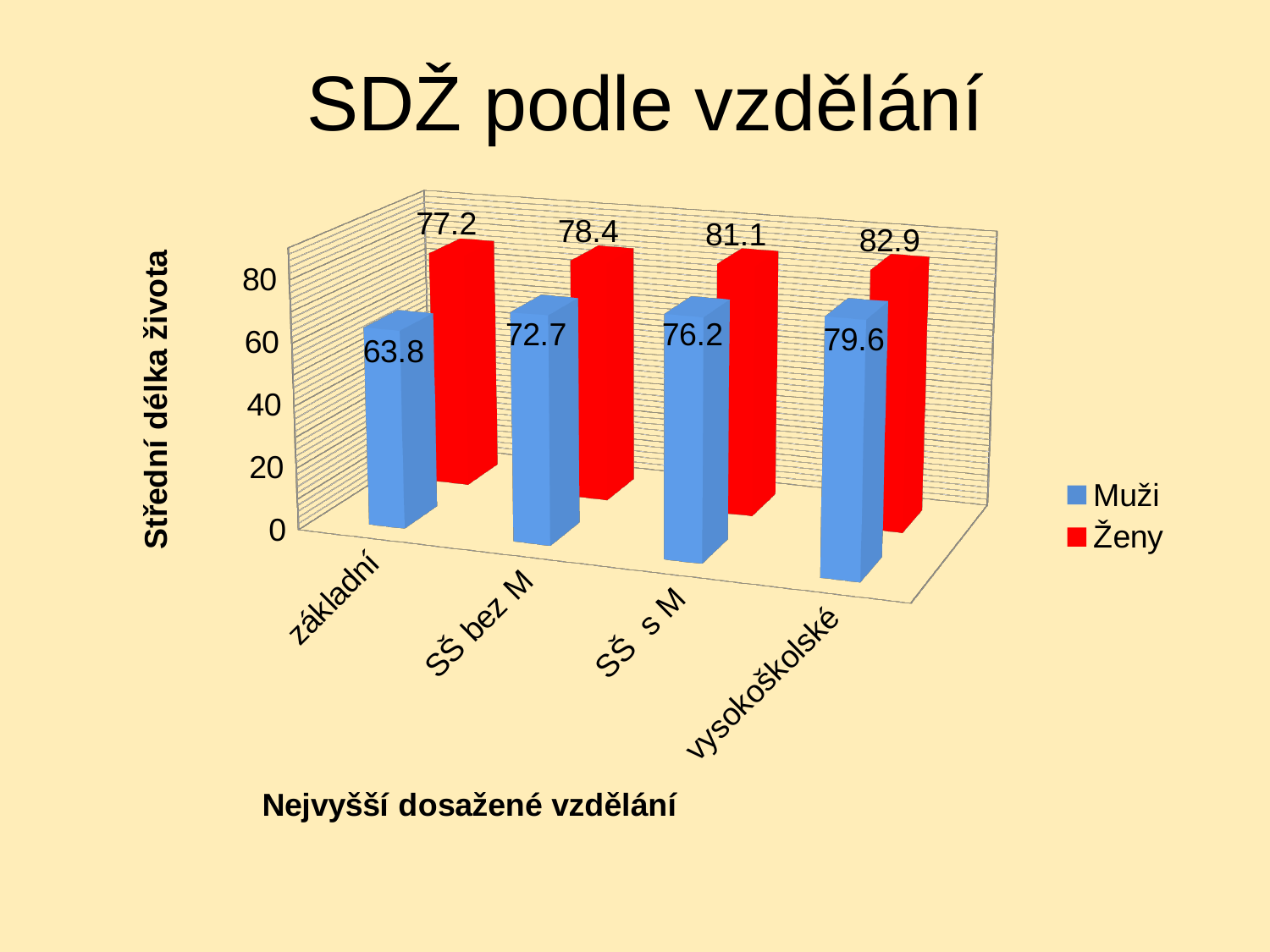
How many series does the legend list? 2 What is the difference between the Ženy and Muži values in the základní category? 13.4 What is the value for Ženy in the SŠ bez M category? 78.4 Which category has the highest value for Muži? vysokoškolské How many education categories are shown on the x axis? 4 What is the value for Muži in the SŠ s M category? 76.2 What is the value for Muži in the základní category? 63.8 Which is larger: the Muži value for vysokoškolské or the Ženy value for základní? Muži value for vysokoškolské What kind of chart is shown on the slide? bar chart What is the value for Ženy in the vysokoškolské category? 82.9 Which category has the lowest value for Ženy? základní Do the Muži values rise or fall from základní to vysokoškolské? rise